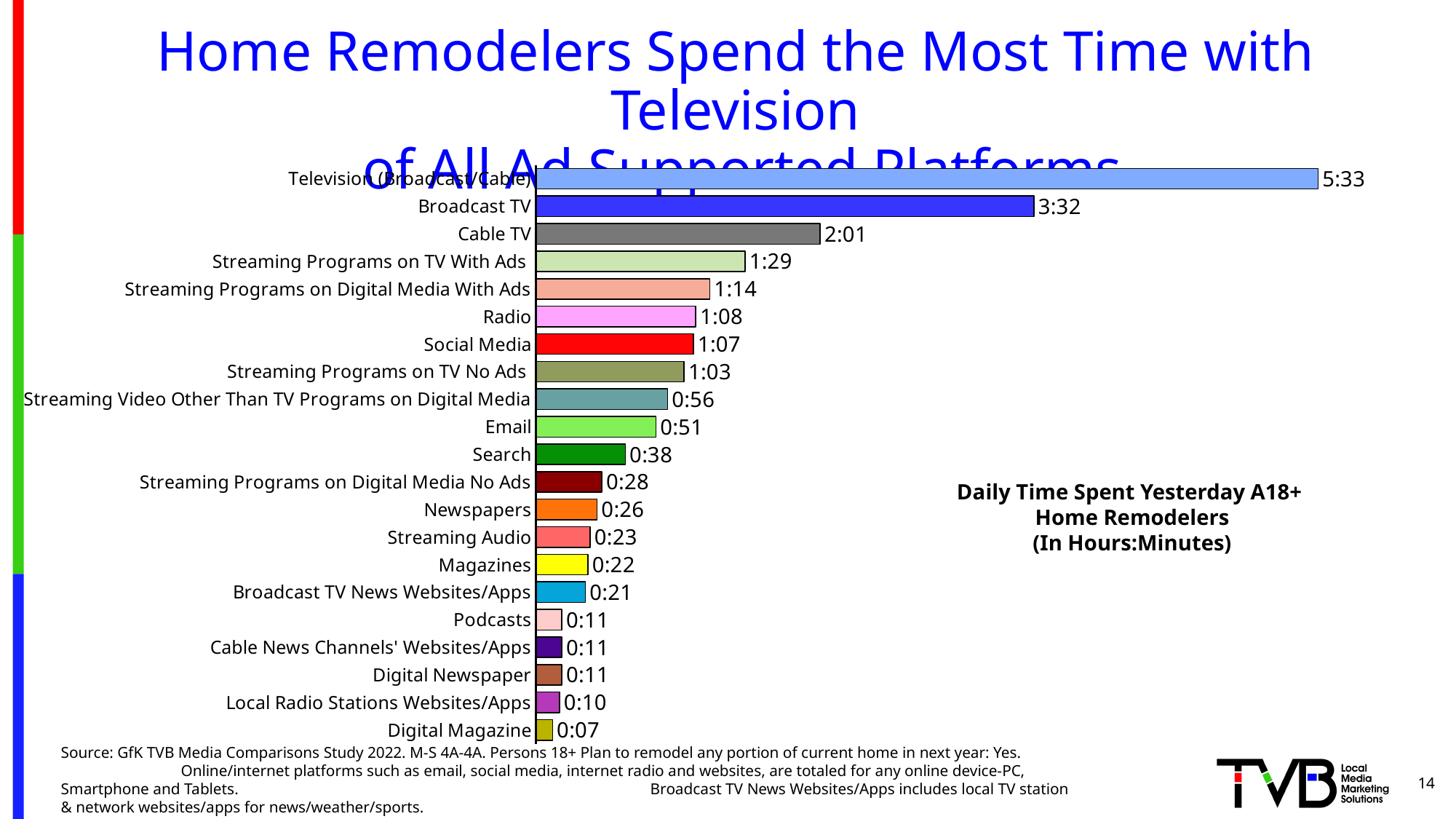
In what units are the chart values expressed, according to the text on the chart? Hours:Minutes What is the value for Radio? 1:08 Which is larger, the value for Newspapers or the value for Magazines? Newspapers What kind of chart is shown on the slide? Bar chart How many categories are shown in the chart? 21 What is the difference between the values for Email and Search? 0:13 Which category has the highest value? Television (Broadcast/Cable) What is the difference between the values for Broadcast TV and Cable TV? 1:31 What is the value for Search? 0:38 What is the value for Digital Magazine? 0:07 What is the value for Broadcast TV? 3:32 Which category has the lowest value? Digital Magazine